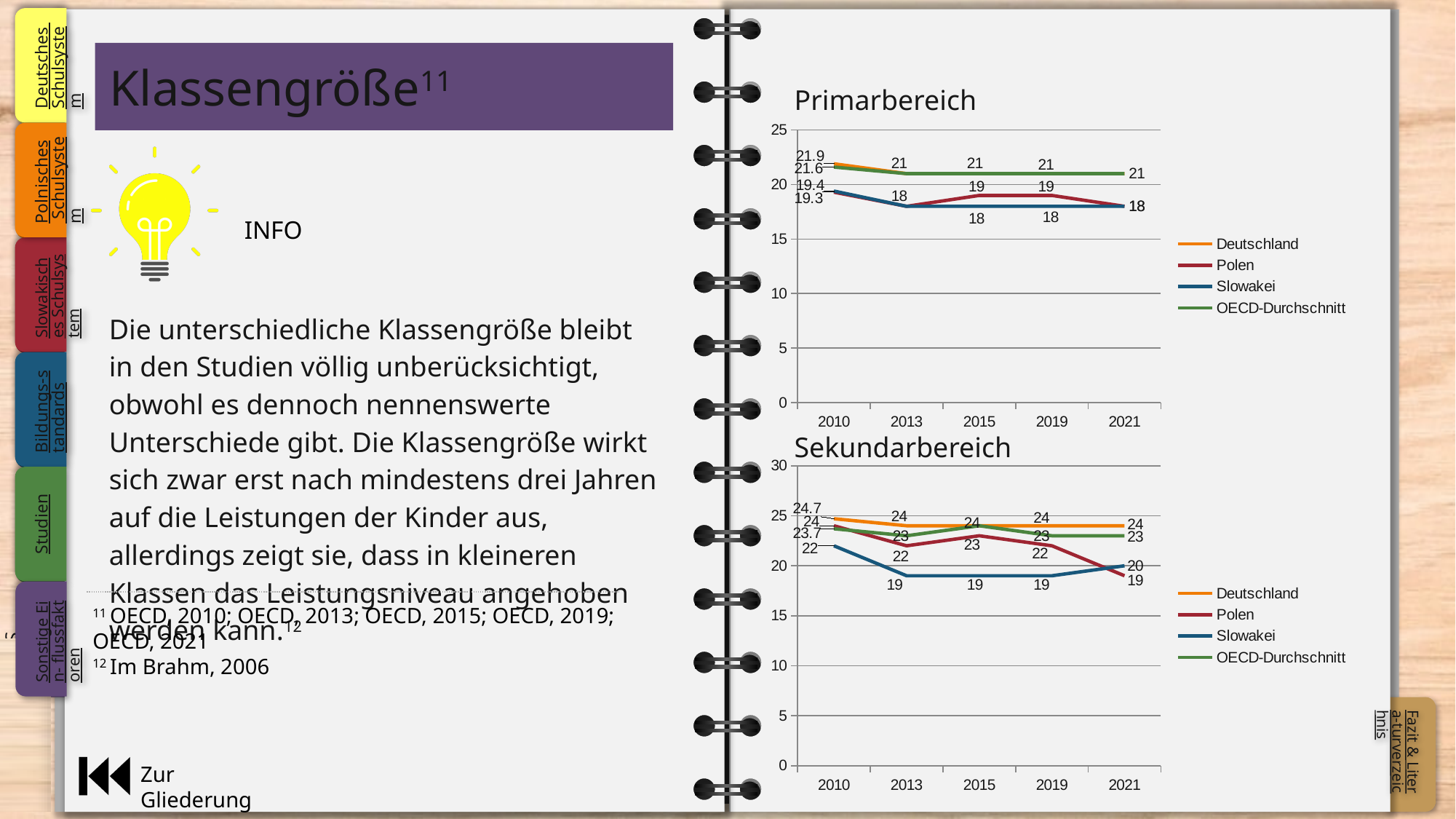
In the Primarbereich chart, what is the value for Slowakei in 2021? 18 In the Primarbereich chart, which is larger in 2021, Deutschland or Slowakei? Deutschland How many series does the legend of the Sekundarbereich chart list? 4 In the Primarbereich chart, what is the value for Polen in 2015? 19 In the Sekundarbereich chart, what is the value for Slowakei in 2010? 22 In the Sekundarbereich chart, which series has the lowest value in 2013? Slowakei In the Sekundarbereich chart, what is the value for Deutschland in 2010? 24.7 How many years are shown on the x axis of the Primarbereich chart? 5 In the Sekundarbereich chart, what is the value for Polen in 2021? 19 In the Primarbereich chart, what is the value for Deutschland in 2010? 21.9 What kind of chart is the Primarbereich chart? line chart In the Sekundarbereich chart, what is the difference between Deutschland and Polen in 2021? 5